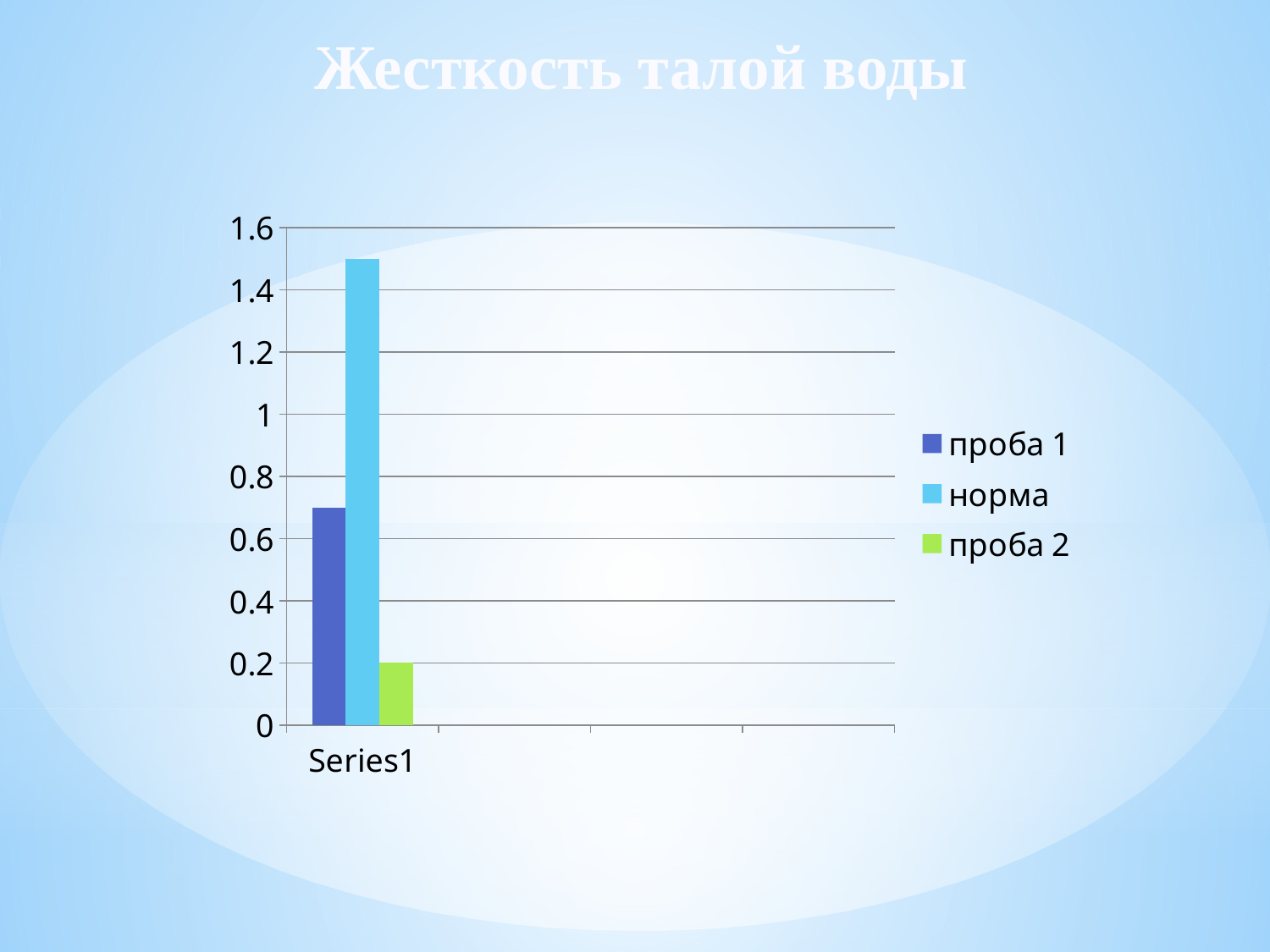
Is the value for норма greater or less than 1.4? greater Is the value for проба 1 greater or less than 1? less What is the title of the chart? Жесткость талой воды How many series does the legend list? 3 Which series has the lowest bar? проба 2 Is the value for проба 1 greater or less than 0.6? greater What kind of chart is shown on the slide? bar chart How many categories are shown on the x axis? 1 What is the value of the проба 2 bar? 0.2 Which is larger, the bar for проба 1 or the bar for проба 2? проба 1 What is the label of the category on the x axis? Series1 Which series has the highest bar? норма